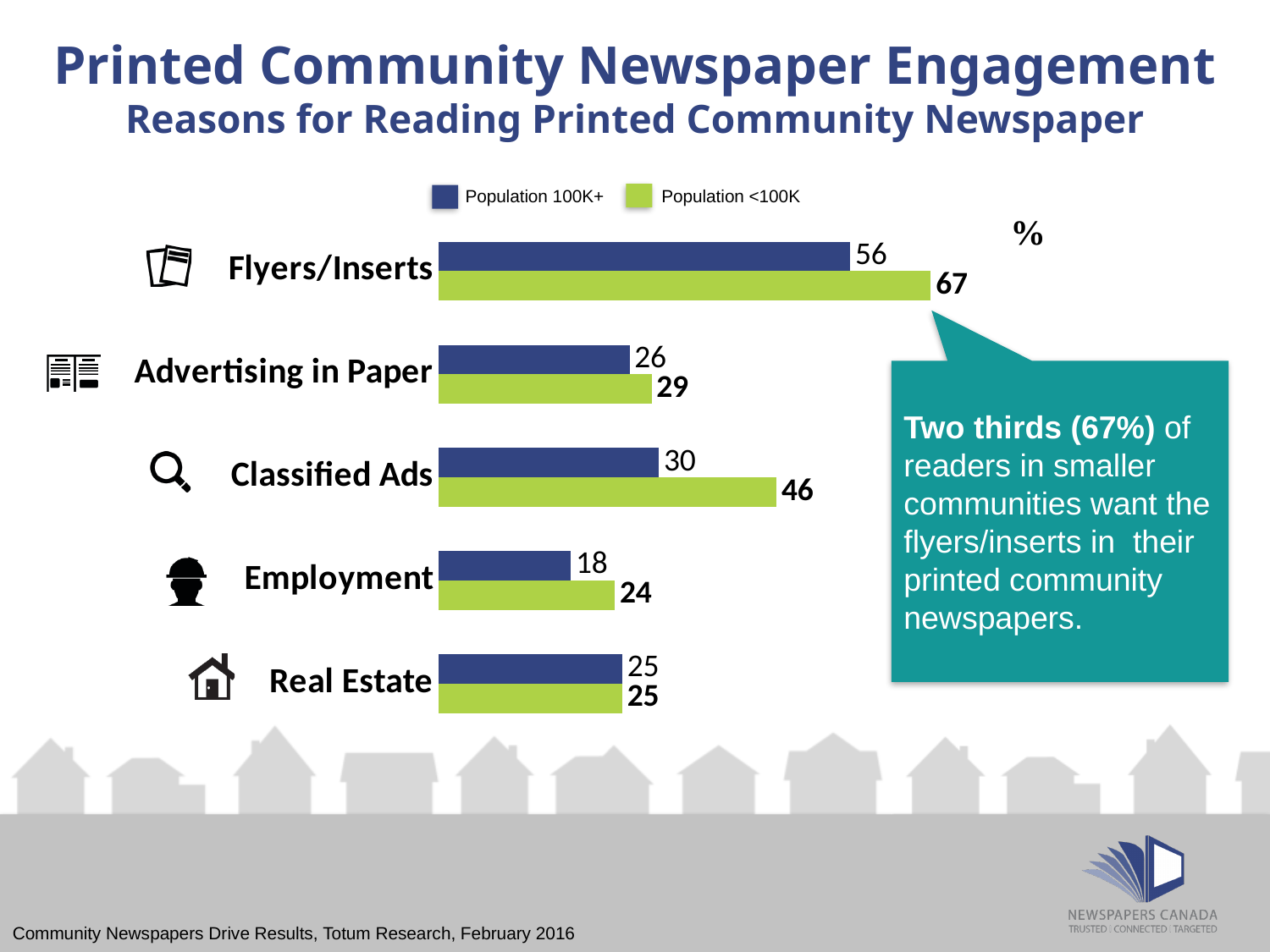
What is the difference between the Population <100K and Population 100K+ values for Classified Ads? 16 What is the difference between the Population <100K and Population 100K+ values for Flyers/Inserts? 11 Which category has the highest value in the Population 100K+ series? Flyers/Inserts What is the value for Flyers/Inserts in the Population <100K series? 67 What is the value for Employment in the Population <100K series? 24 How many categories are shown in the chart? 5 What kind of chart is shown on the slide? Bar chart Which colour represents the Population <100K series in the legend? Green What is the value for Classified Ads in the Population 100K+ series? 30 Which is larger for Advertising in Paper: the Population 100K+ value or the Population <100K value? Population <100K How many series does the legend list? 2 Which category has the lowest value in the Population 100K+ series? Employment